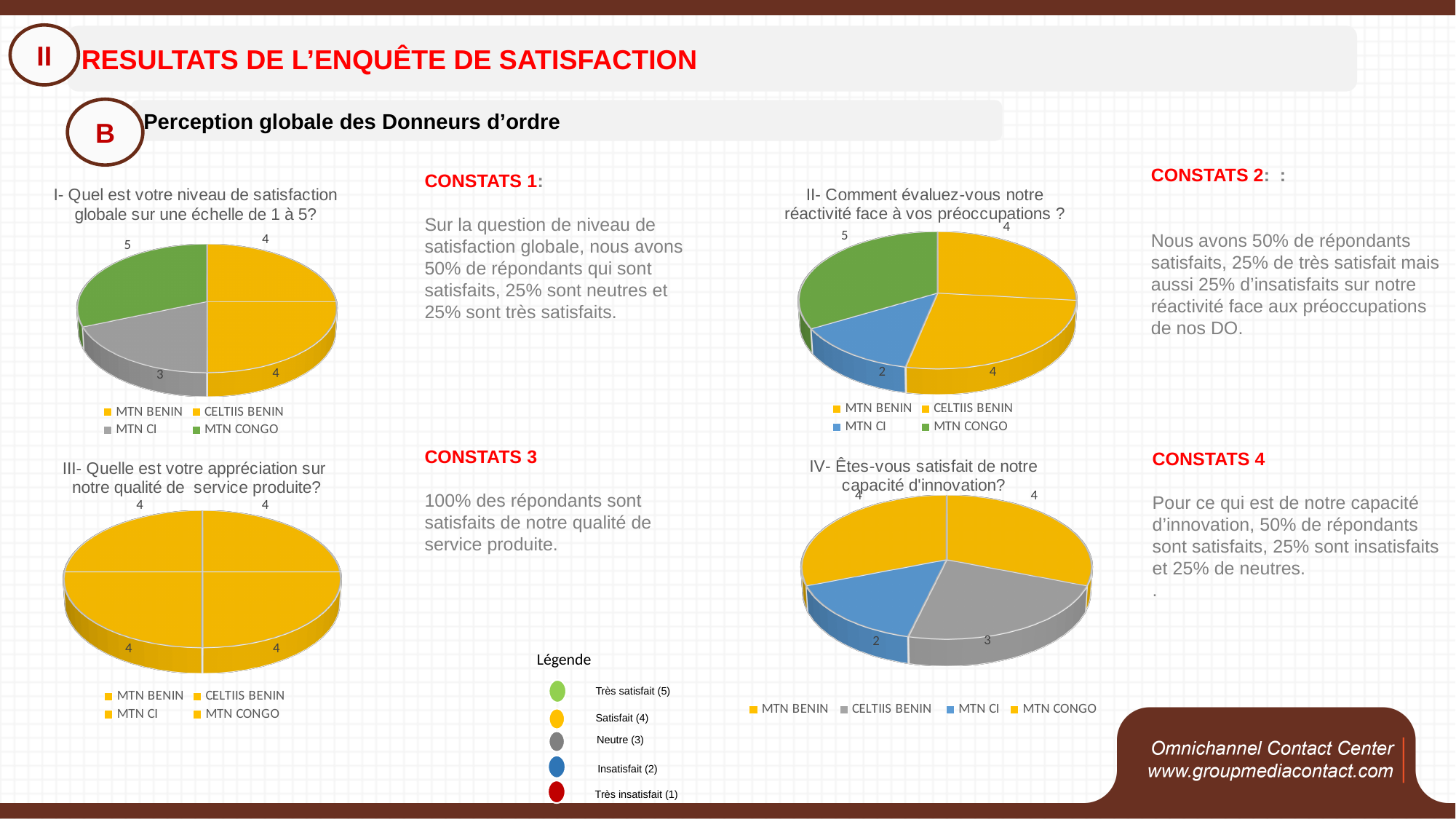
In the chart for question II (réactivité face à vos préoccupations), which category has the lowest value? MTN CI In the chart for question III (qualité de service produite), what share of the pie does MTN BENIN represent? 25% In the chart for question IV (capacité d'innovation), what is the value for CELTIIS BENIN? 3 In the chart for question I (satisfaction globale), which category has the highest value? MTN CONGO In the chart for question II (réactivité face à vos préoccupations), what is the difference between the values for MTN CONGO and MTN CI? 3 In the chart for question I (satisfaction globale), what is the value for MTN CONGO? 5 In the chart for question IV (capacité d'innovation), which is larger: the value for MTN BENIN or the value for MTN CI? MTN BENIN In the chart for question III (qualité de service produite), what is the value for MTN CONGO? 4 What kind of chart is used for question I ("Quel est votre niveau de satisfaction globale sur une échelle de 1 à 5?")? Pie chart In the chart for question I (satisfaction globale), what is the value for MTN CI? 3 In the chart for question II (réactivité face à vos préoccupations), what is the value for MTN CI? 2 In the chart for question I (satisfaction globale), how many categories does the legend list? 4